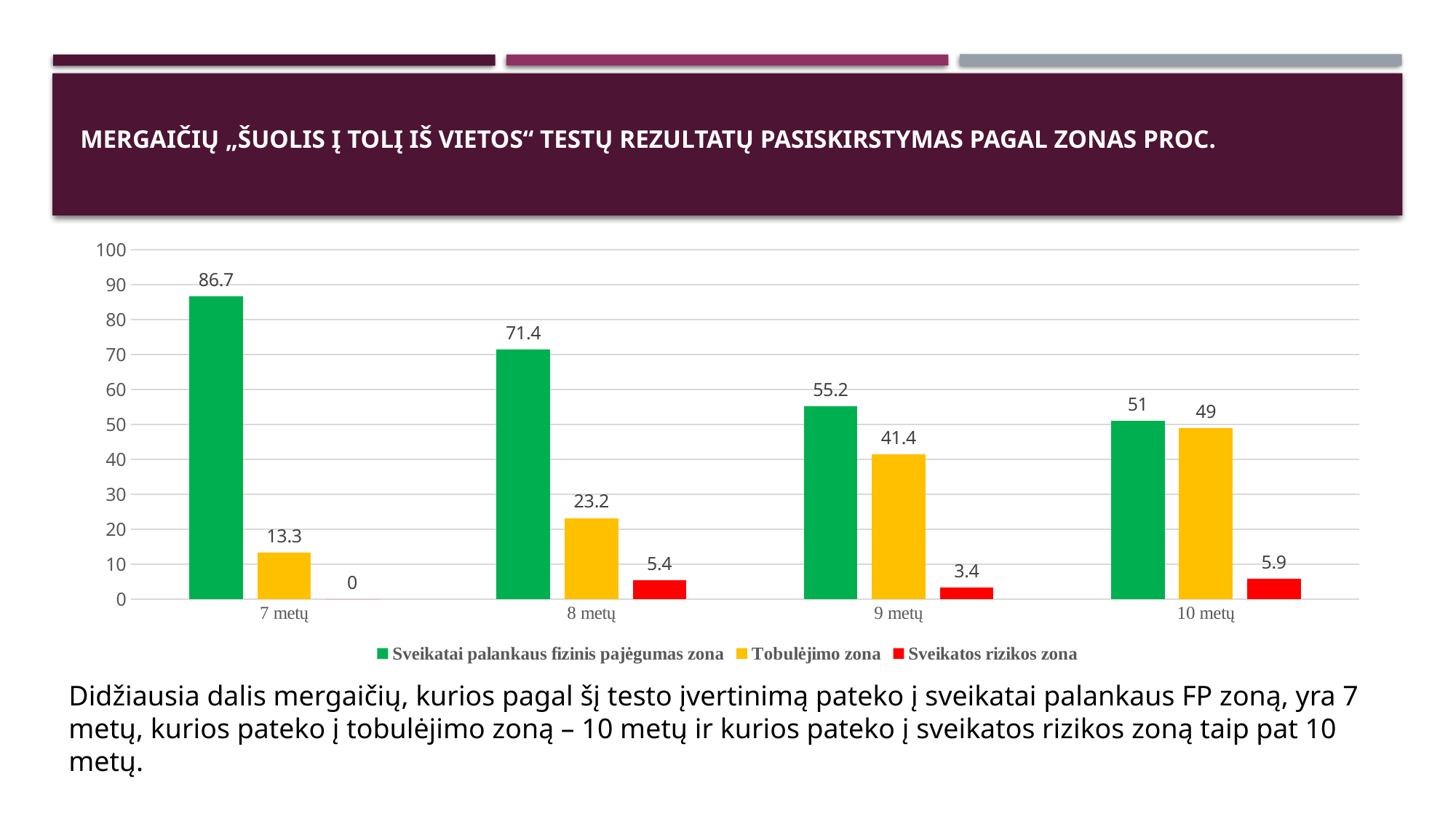
Which age group has the lowest value for 'Sveikatos rizikos zona'? 7 metų How many series does the legend list? 3 Do the values for 'Sveikatai palankaus fizinis pajėgumas zona' rise or fall from 7 metų to 10 metų? Fall What is the value for 'Sveikatos rizikos zona' for 8 metų? 5.4 What is the difference between the 'Sveikatai palankaus fizinis pajėgumas zona' and 'Tobulėjimo zona' values for 10 metų? 2 What is the value for 'Sveikatai palankaus fizinis pajėgumas zona' for 7 metų? 86.7 Which is larger for 8 metų: 'Tobulėjimo zona' or 'Sveikatos rizikos zona'? Tobulėjimo zona Which colour represents 'Sveikatos rizikos zona' in the chart? Red Which age group has the highest value for 'Sveikatai palankaus fizinis pajėgumas zona'? 7 metų What is the value for 'Tobulėjimo zona' for 9 metų? 41.4 What kind of chart is shown on the slide? Bar chart How many age groups are shown on the x axis? 4